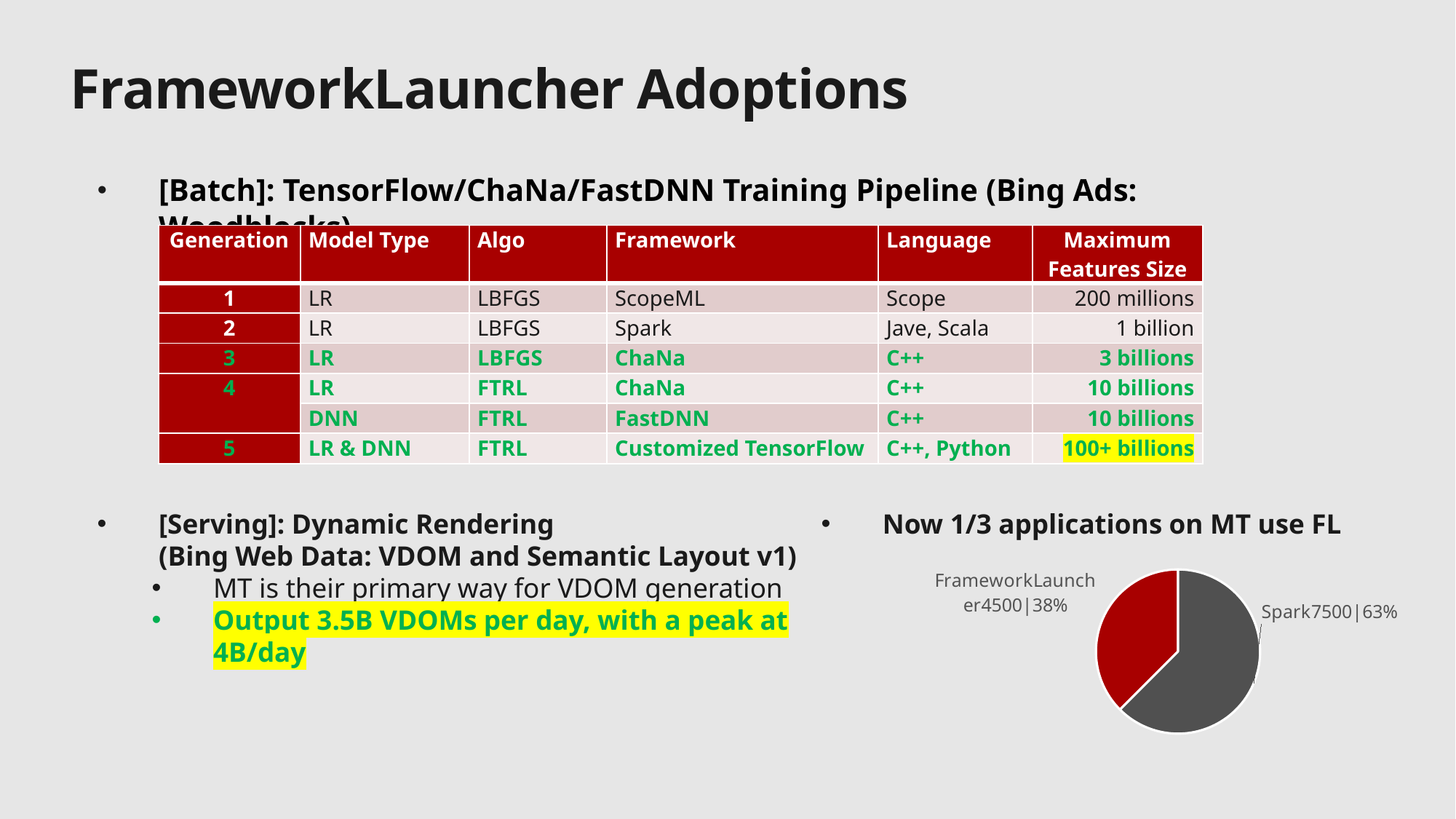
What share of the pie does FrameworkLauncher represent? 38% What kind of chart is shown at the bottom right of the slide? pie chart Which is larger in the pie chart, Spark or FrameworkLauncher? Spark Which slice of the pie chart is the largest? Spark Which slice of the pie chart is the smallest? FrameworkLauncher What colour is the FrameworkLauncher slice in the pie chart? dark red What share of the pie does Spark represent? 63% What value is shown for FrameworkLauncher in the pie chart? 4500 What is the difference between the Spark value and the FrameworkLauncher value in the pie chart? 3000 What value is shown for Spark in the pie chart? 7500 How many slices does the pie chart have? 2 What colour is the Spark slice in the pie chart? dark grey